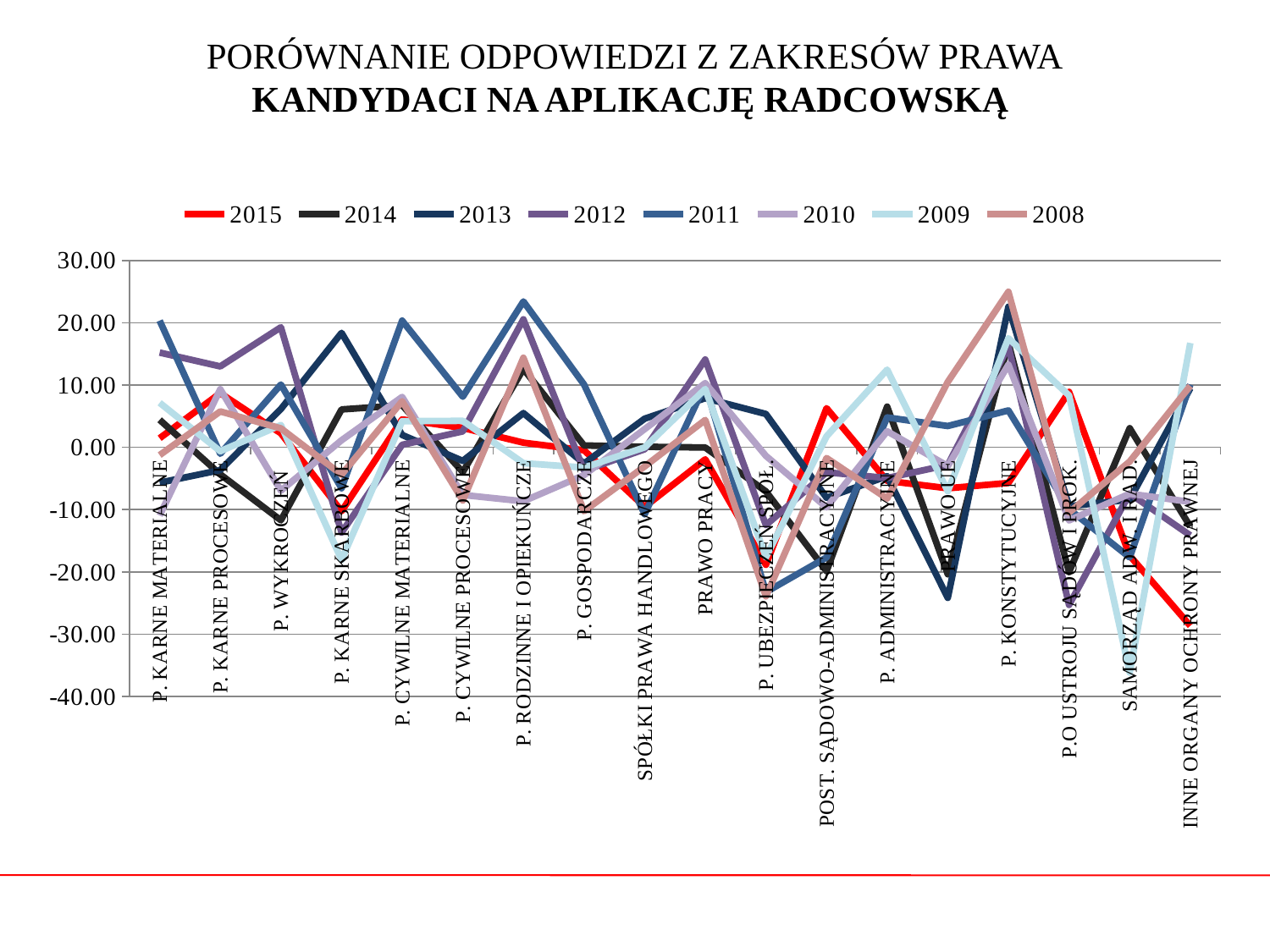
Is the value for 2013 at PRAWO UE greater or less than -20? less Is the value for 2012 at P. WYKROCZEŃ greater or less than 10? greater Is the value for 2011 at P. RODZINNE I OPIEKUŃCZE greater or less than 20? greater Which series has the highest value at P. RODZINNE I OPIEKUŃCZE? 2011 Which series has the lowest value at SAMORZĄD ADW. I RAD.? 2009 Which year is listed first in the legend? 2015 How many categories are plotted along the x axis? 18 How many series does the legend list? 8 What kind of chart is shown on the slide? line chart